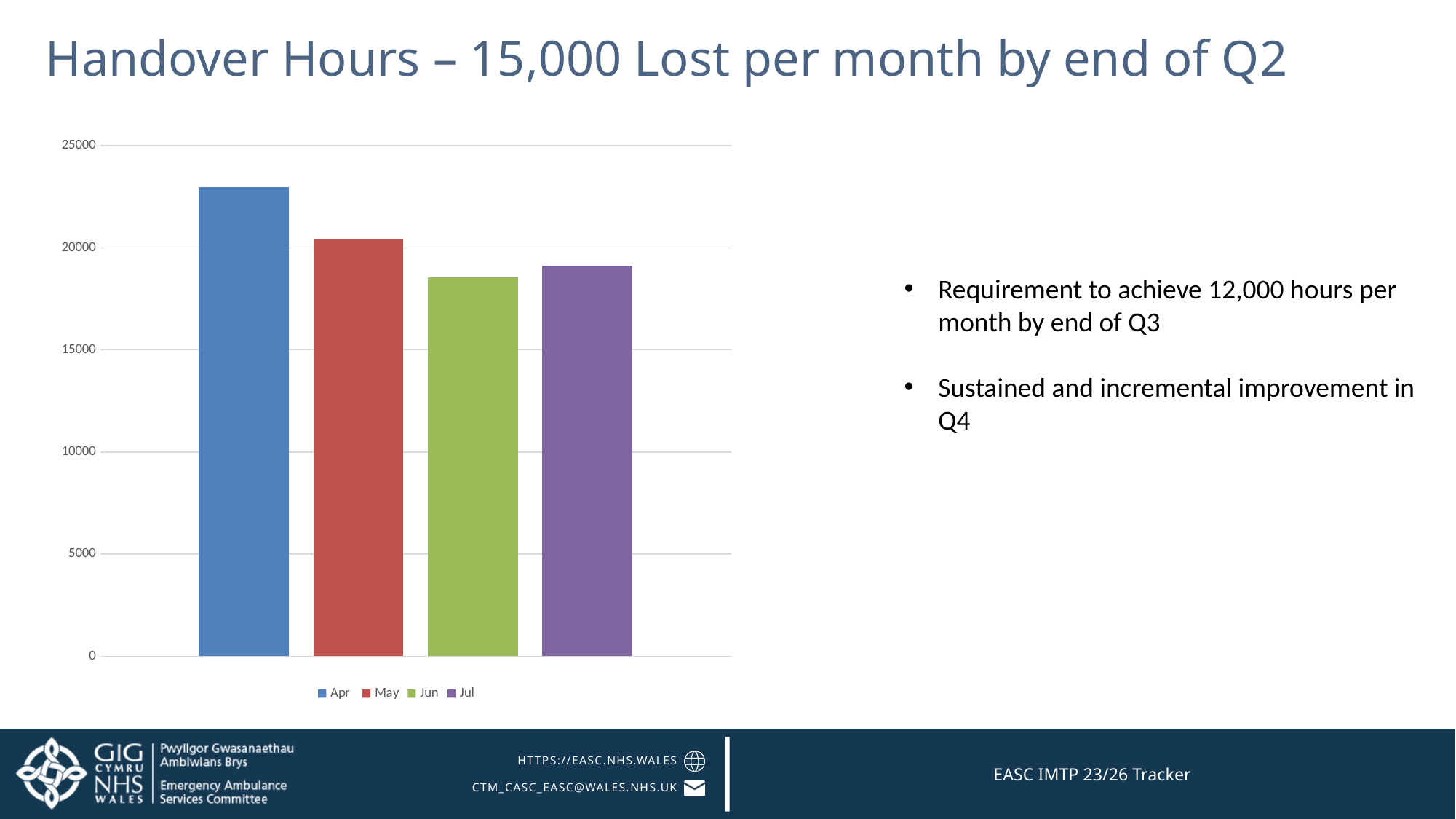
What kind of chart is shown on the slide? Bar chart Do the values rise or fall from Apr to Jun? fall Which month has the lowest bar in the chart? Jun Is the value for Jul greater or less than 20000? less How many bars are plotted in the chart? 4 Is the value for Jun greater or less than 15000? greater What colour is the bar for May in the chart? Red Which month has the highest bar in the chart? Apr Which is larger, the value for Apr or the value for May? Apr Which is larger, the value for Jun or the value for Jul? Jul How many series does the chart legend list? 4 Is the value for Apr greater or less than 20000? greater